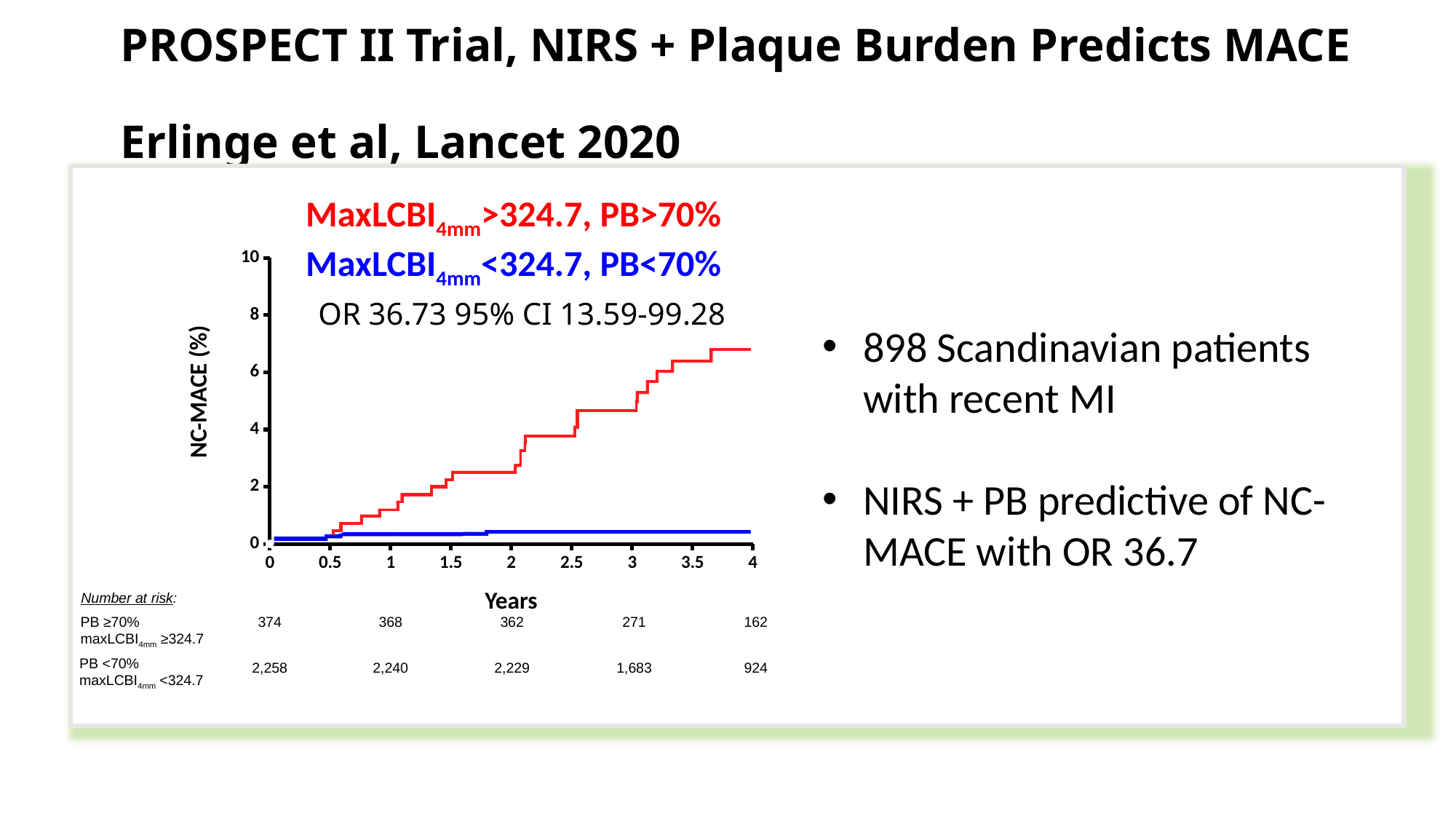
Is the NC-MACE value of the red curve at 4 years greater or less than 6? greater In the number-at-risk table, how many patients were at risk in the PB ≥70%, maxLCBI4mm ≥324.7 group at year 3? 271 How many groups (curves) are plotted on the chart? 2 In the number-at-risk table, how many patients were at risk in the PB <70%, maxLCBI4mm <324.7 group at year 4? 924 Does the red curve rise or fall as years increase? Rises What is the label of the y axis of the chart? NC-MACE (%) What is the difference between the number at risk at year 0 in the PB <70% group (2,258) and the PB ≥70% group (374)? 1,884 Which curve shows the higher NC-MACE rate at 4 years, the red (MaxLCBI4mm>324.7, PB>70%) or the blue (MaxLCBI4mm<324.7, PB<70%)? Red (MaxLCBI4mm>324.7, PB>70%) In the number-at-risk table, how many patients were at risk in the PB ≥70%, maxLCBI4mm ≥324.7 group at year 0? 374 Is the NC-MACE value of the blue curve at 4 years greater or less than 2? less What is the label of the x axis of the chart? Years What kind of chart is shown on the slide? Line chart